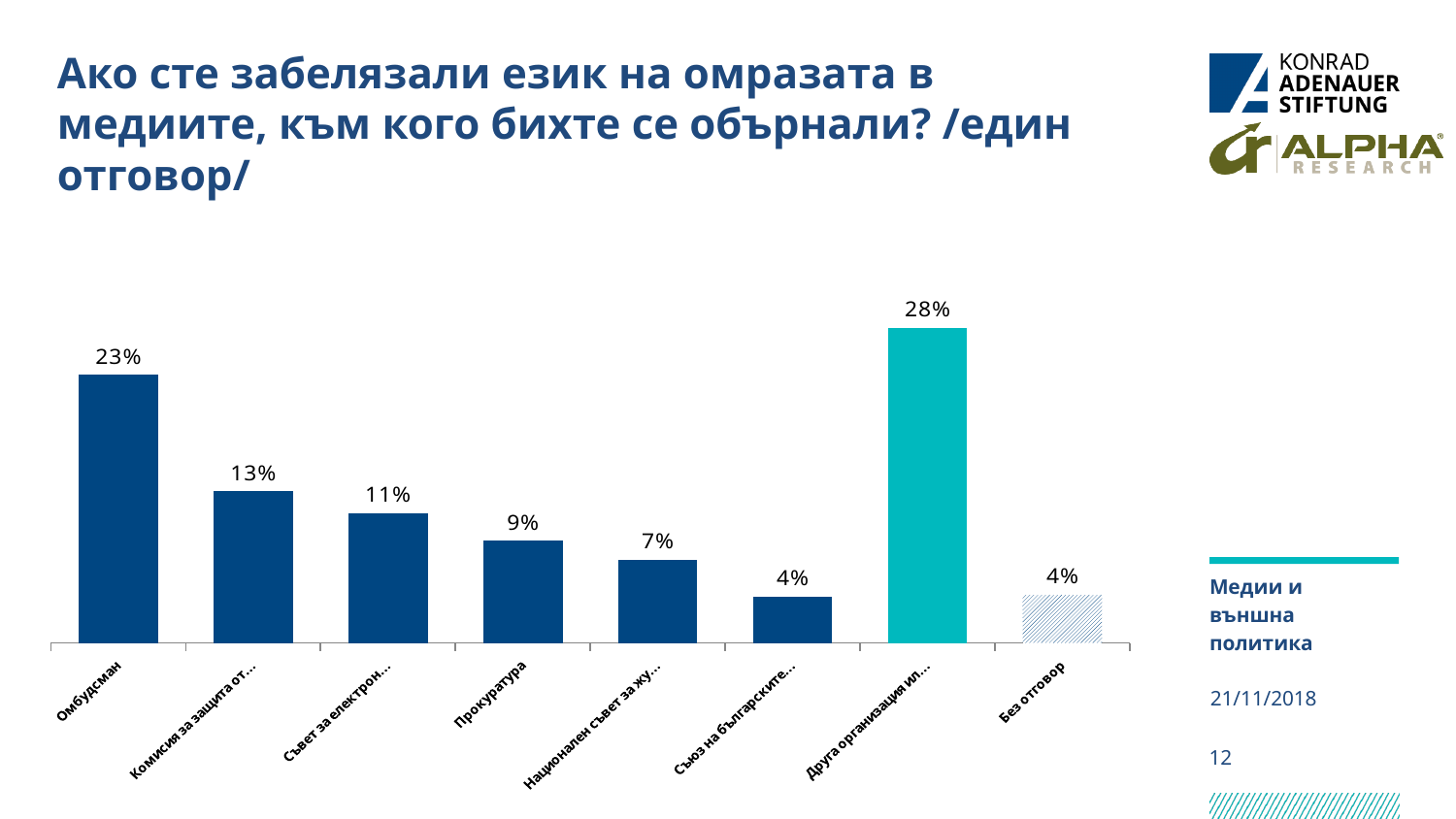
What is the lowest value shown on the chart? 4% What percentage is shown for Омбудсман? 23% What is the highest value shown on the chart? 28% What is the difference between the values for Омбудсман and Прокуратура? 14 percentage points What percentage is shown for Без отговор? 4% Which has a larger value, Прокуратура or Без отговор? Прокуратура What percentage is shown for Прокуратура? 9% What is the difference between the highest value (28%) and the value for Омбудсман? 5 percentage points How many categories are shown on the chart? 8 Which has a larger value, Омбудсман or Прокуратура? Омбудсман Which bar on the chart is drawn with a hatched pattern rather than a solid fill? Без отговор What kind of chart is shown on the slide? Bar chart